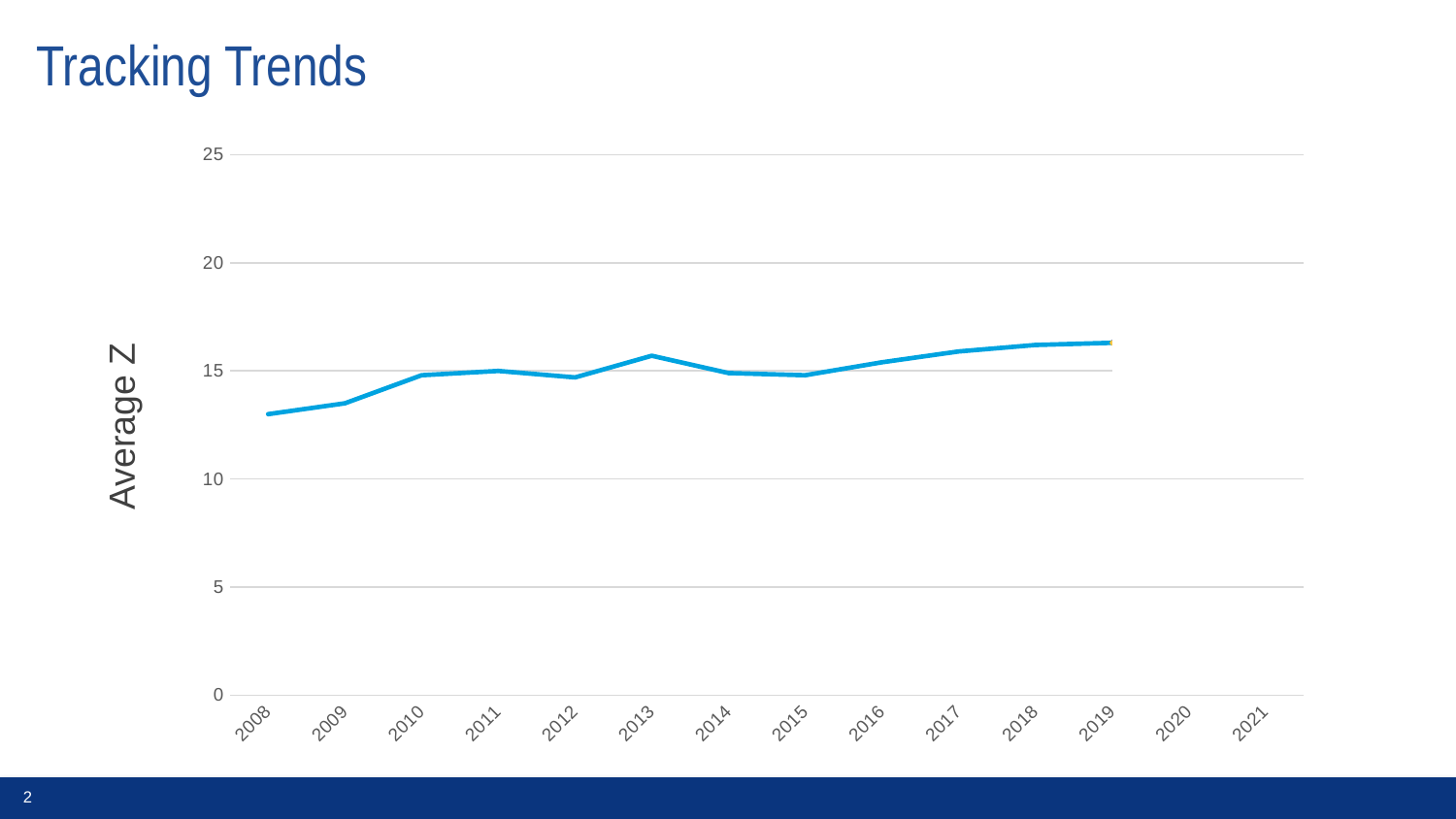
Is the value for 2013 greater or less than 15? greater Which is larger, the value for 2012 or the value for 2013? 2013 Which is larger, the value for 2008 or the value for 2019? 2019 What is the title of the slide's chart? Tracking Trends Is the value for 2019 greater or less than 15? greater Overall, do the values rise or fall from 2008 to 2019? rise Is the value for 2018 greater or less than 20? less Which year has the lowest value on the chart? 2008 What kind of chart is shown on the slide? line chart What is the label on the vertical axis of the chart? Average Z